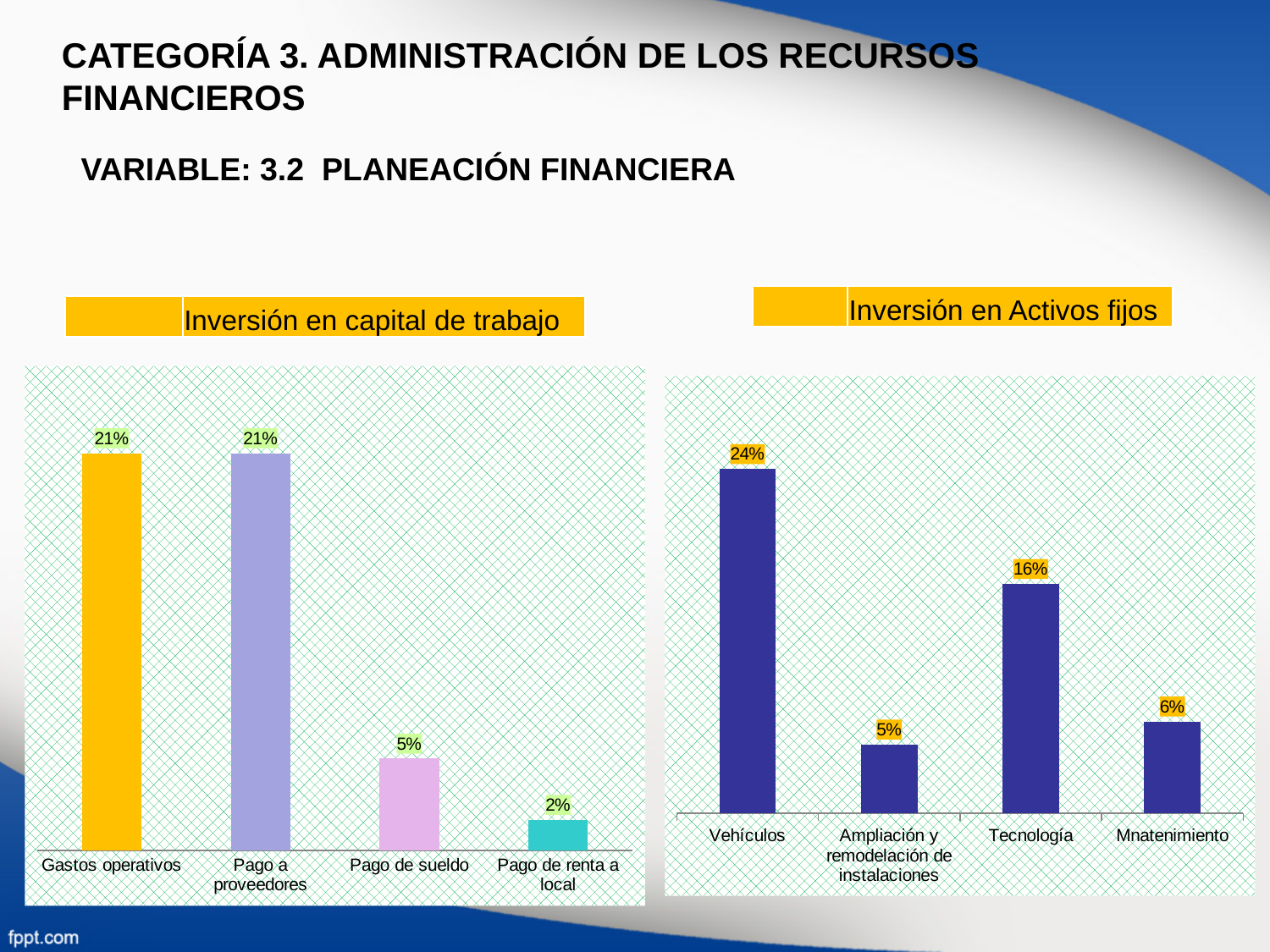
What type of chart is the 'Inversión en Activos fijos' chart? Bar chart In the 'Inversión en capital de trabajo' chart, how many categories are shown? 4 In the 'Inversión en capital de trabajo' chart, what is the value for Pago de renta a local? 2% In the 'Inversión en Activos fijos' chart, what is the difference between Vehículos and Mnatenimiento? 18% In the 'Inversión en Activos fijos' chart, which category has the highest value? Vehículos In the 'Inversión en Activos fijos' chart, what is the value for Vehículos? 24% In the 'Inversión en capital de trabajo' chart, which category has the lowest value? Pago de renta a local In the 'Inversión en capital de trabajo' chart, what is the difference between Gastos operativos and Pago de sueldo? 16% In the 'Inversión en capital de trabajo' chart, what is the value for Pago de sueldo? 5% In the 'Inversión en Activos fijos' chart, which is larger: Tecnología or Mnatenimiento? Tecnología In the 'Inversión en Activos fijos' chart, which category has the lowest value? Ampliación y remodelación de instalaciones In the 'Inversión en Activos fijos' chart, what is the value for Tecnología? 16%